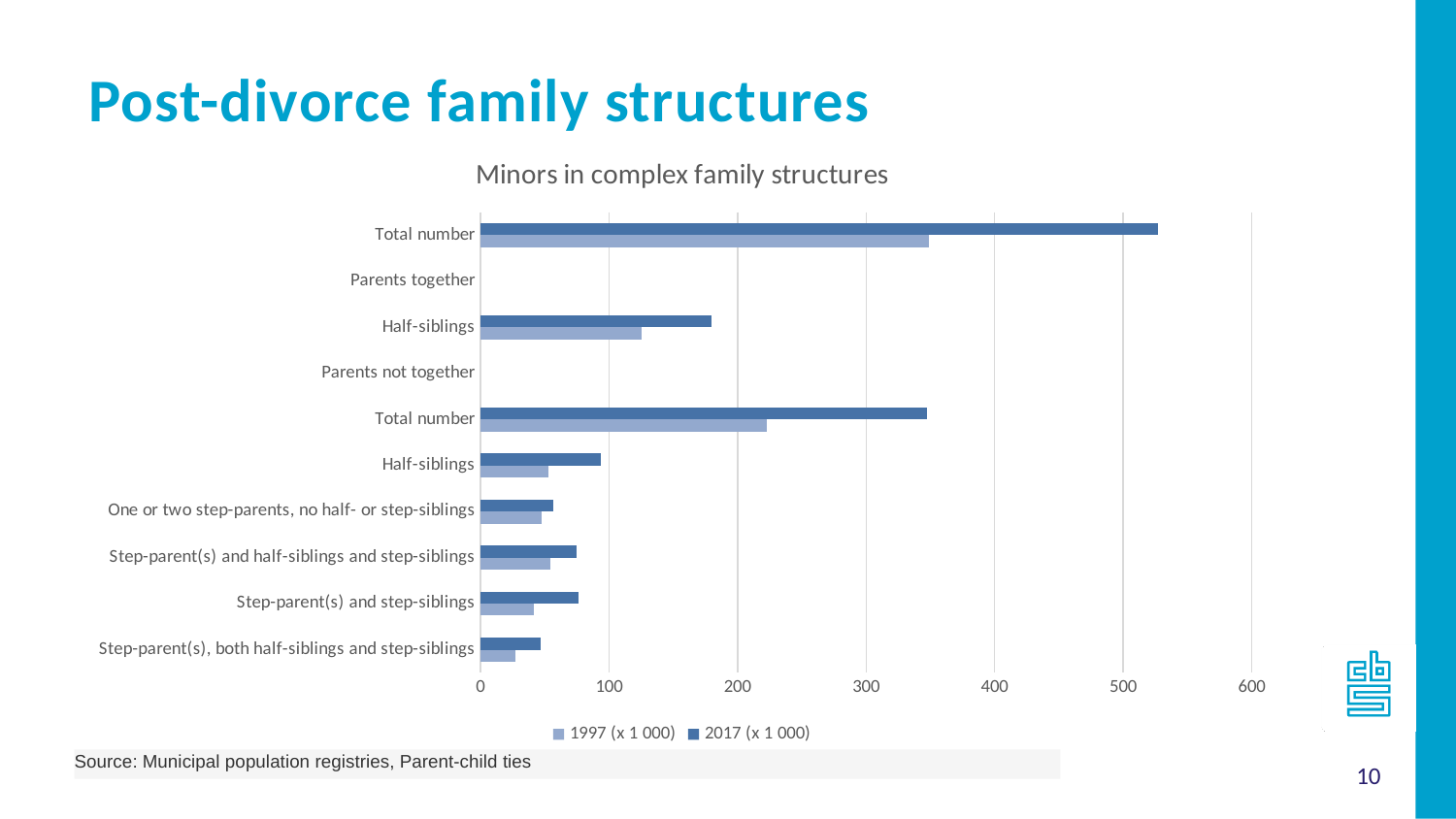
What kind of chart is shown on the slide? bar chart How many category labels are listed on the vertical axis of the chart? 10 How many series does the legend list? 2 Which bar is the longest in the chart? 2017 for the topmost Total number Is the 1997 value for the topmost 'Total number' bar greater or less than 300? greater For the topmost 'Total number' category, which series has the larger value, 1997 or 2017? 2017 Is the 2017 value for the topmost 'Total number' bar greater or less than 500? greater Is the 2017 value for 'Half-siblings' under 'Parents not together' greater or less than 100? less What are the two series named in the legend? 1997 (x 1 000) and 2017 (x 1 000) What is the title of the chart? Minors in complex family structures